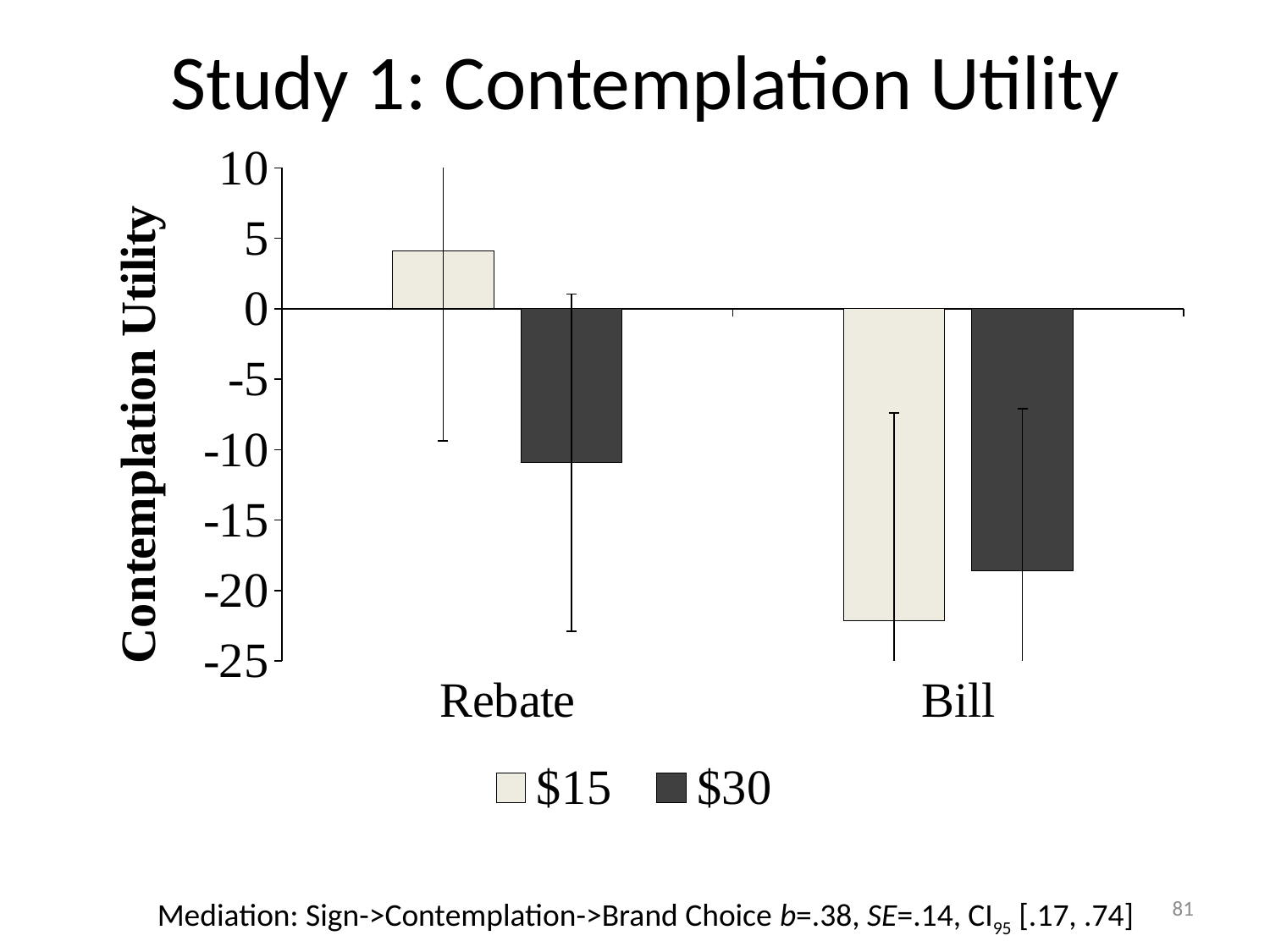
In the Rebate category, which series has the larger value, $15 or $30? $15 Is the value for $15 in the Rebate category greater or less than 0? greater What is the title of the chart's vertical axis? Contemplation Utility Is the value for $30 in the Rebate category greater or less than -5? less How many series does the chart's legend list? 2 In the Bill category, which series has the larger value, $15 or $30? $30 Which series and category combination has the lowest contemplation utility? $15 in Bill How many categories are shown on the x axis of the chart? 2 Is the value for $15 in the Bill category greater or less than -20? less Which series and category combination has the highest contemplation utility? $15 in Rebate What kind of chart is shown on the slide? bar chart